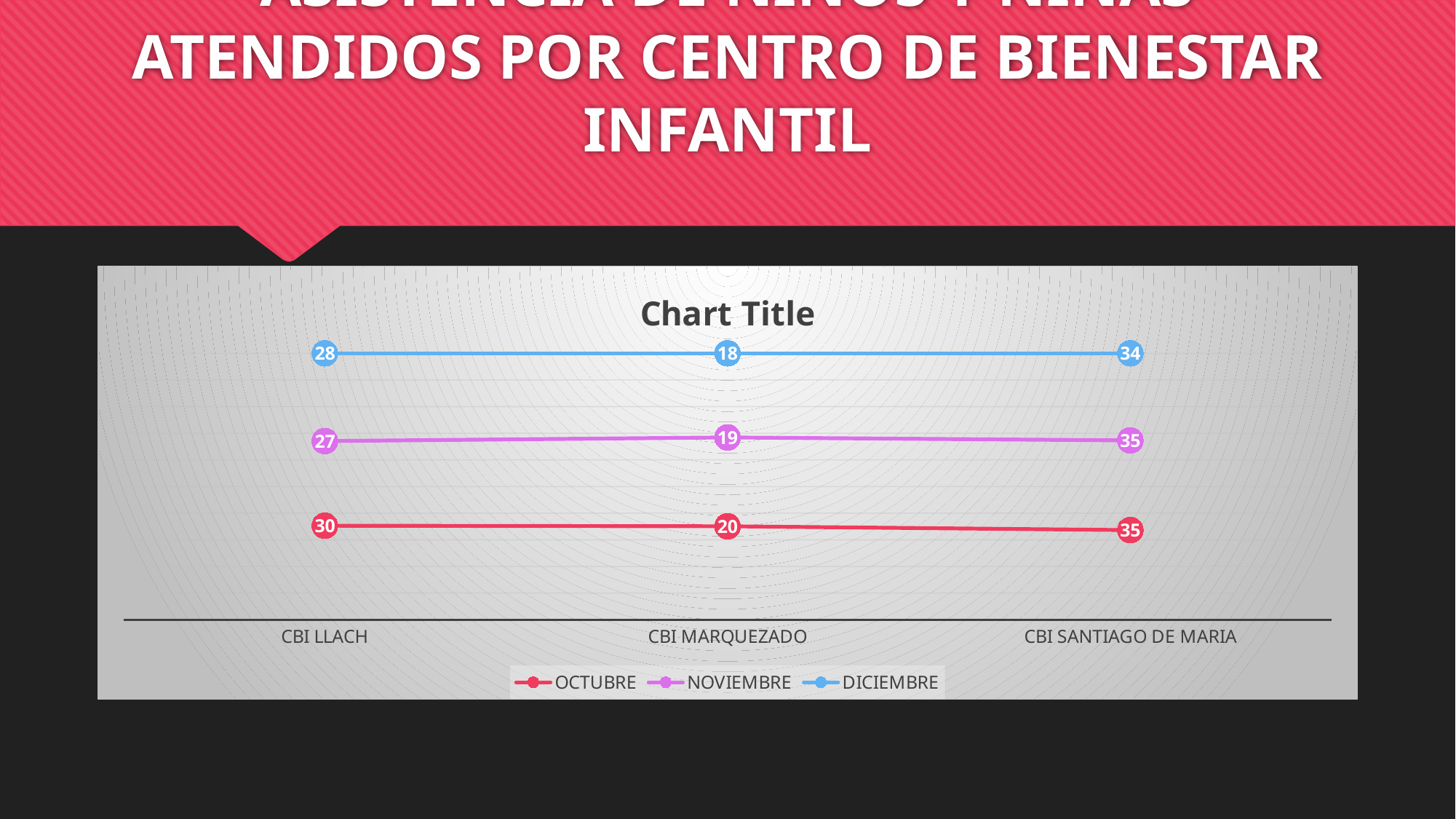
How many centres are shown on the x axis? 3 What kind of chart is shown on the slide? Line chart Which centre has the lowest OCTUBRE value? CBI MARQUEZADO What is the OCTUBRE value for CBI LLACH? 30 What is the DICIEMBRE value for CBI MARQUEZADO? 18 How many series does the legend list? 3 Which is larger for CBI LLACH, the OCTUBRE value or the DICIEMBRE value? OCTUBRE What is the DICIEMBRE value for CBI SANTIAGO DE MARIA? 34 What is the difference between the OCTUBRE values for CBI LLACH and CBI MARQUEZADO? 10 Which centre has the highest DICIEMBRE value? CBI SANTIAGO DE MARIA What is the difference between the NOVIEMBRE values for CBI SANTIAGO DE MARIA and CBI LLACH? 8 What is the NOVIEMBRE value for CBI SANTIAGO DE MARIA? 35